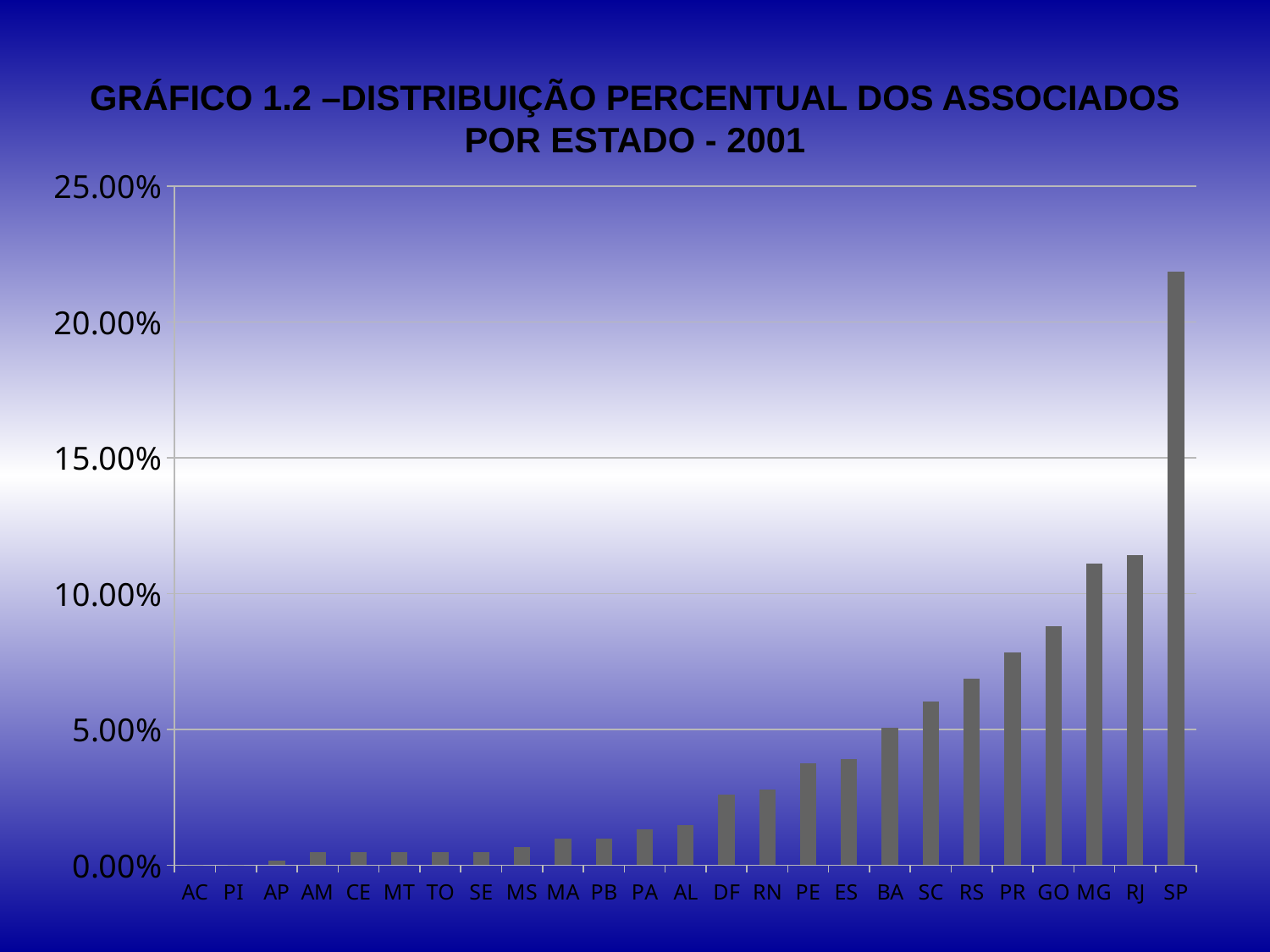
Is the value for GO greater or less than 10.00%? less How many states are shown on the x axis? 25 What year does the chart title refer to? 2001 Is the value for SP greater or less than 20.00%? greater Is the value for RJ greater or less than 10.00%? greater What kind of chart is shown on the slide? bar chart Which is larger, the value for GO or the value for PR? GO Do the values rise or fall moving from left to right along the x axis? rise Which is larger, the value for SP or the value for RJ? SP Which state has the highest percentage of associates? SP